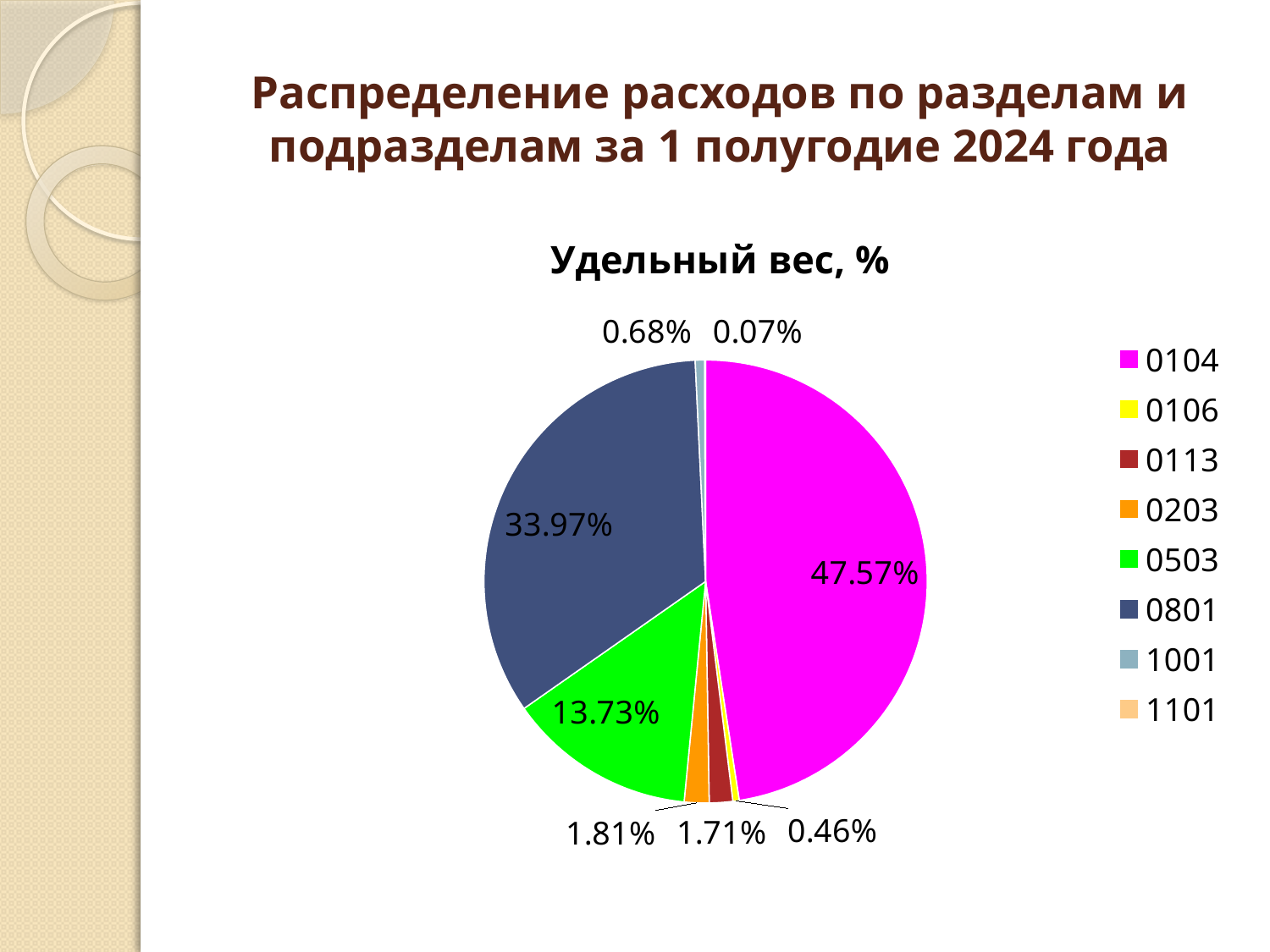
What is the share for category 0503? 13.73% What is the title of the chart? Удельный вес, % How many categories does the legend list? 8 What is the share for category 0801? 33.97% Which category has the largest share of the pie? 0104 Which has a larger share, 0503 or 0801? 0801 What is the share for category 0203? 1.81% Which category has the smallest share of the pie? 1101 What is the difference between the shares of 0104 and 0801? 13.60% What type of chart is shown on the slide? pie chart What is the share for category 0104? 47.57% What is the share for category 1101? 0.07%